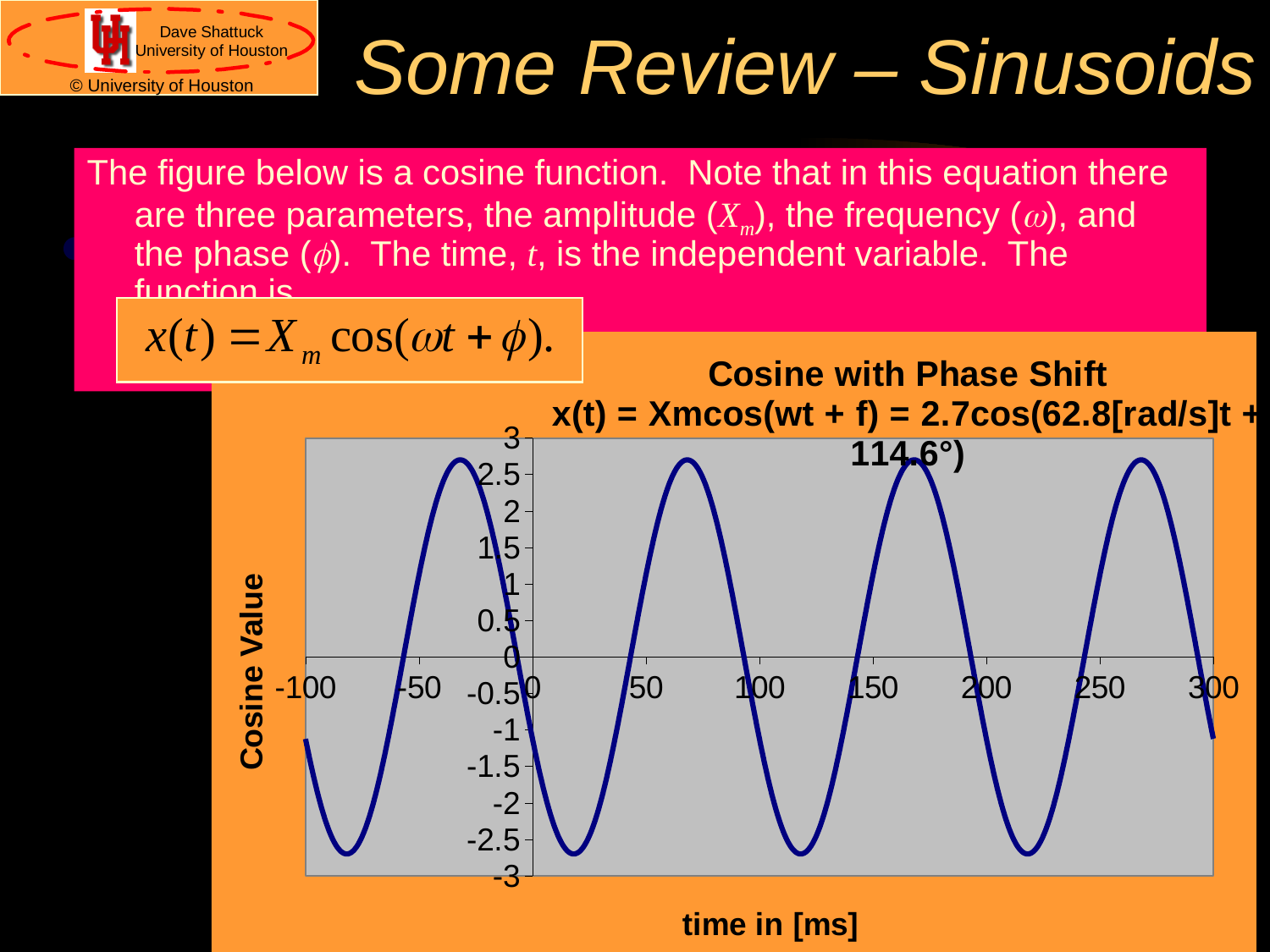
How many lines (series) are plotted on the chart? 1 Is the peak value of the cosine curve greater or less than 3? less Is the value of the cosine curve at time 0 ms greater or less than 0? less Is the value of the cosine curve at time 100 ms greater or less than 0? less What is the smallest time value shown on the horizontal axis? -100 What kind of chart is shown on the slide? line chart What is the title of the chart? Cosine with Phase Shift x(t) = Xmcos(wt + f) = 2.7cos(62.8[rad/s]t + 114.6°) What is the label of the horizontal axis of the chart? time in [ms] What is the largest time value shown on the horizontal axis? 300